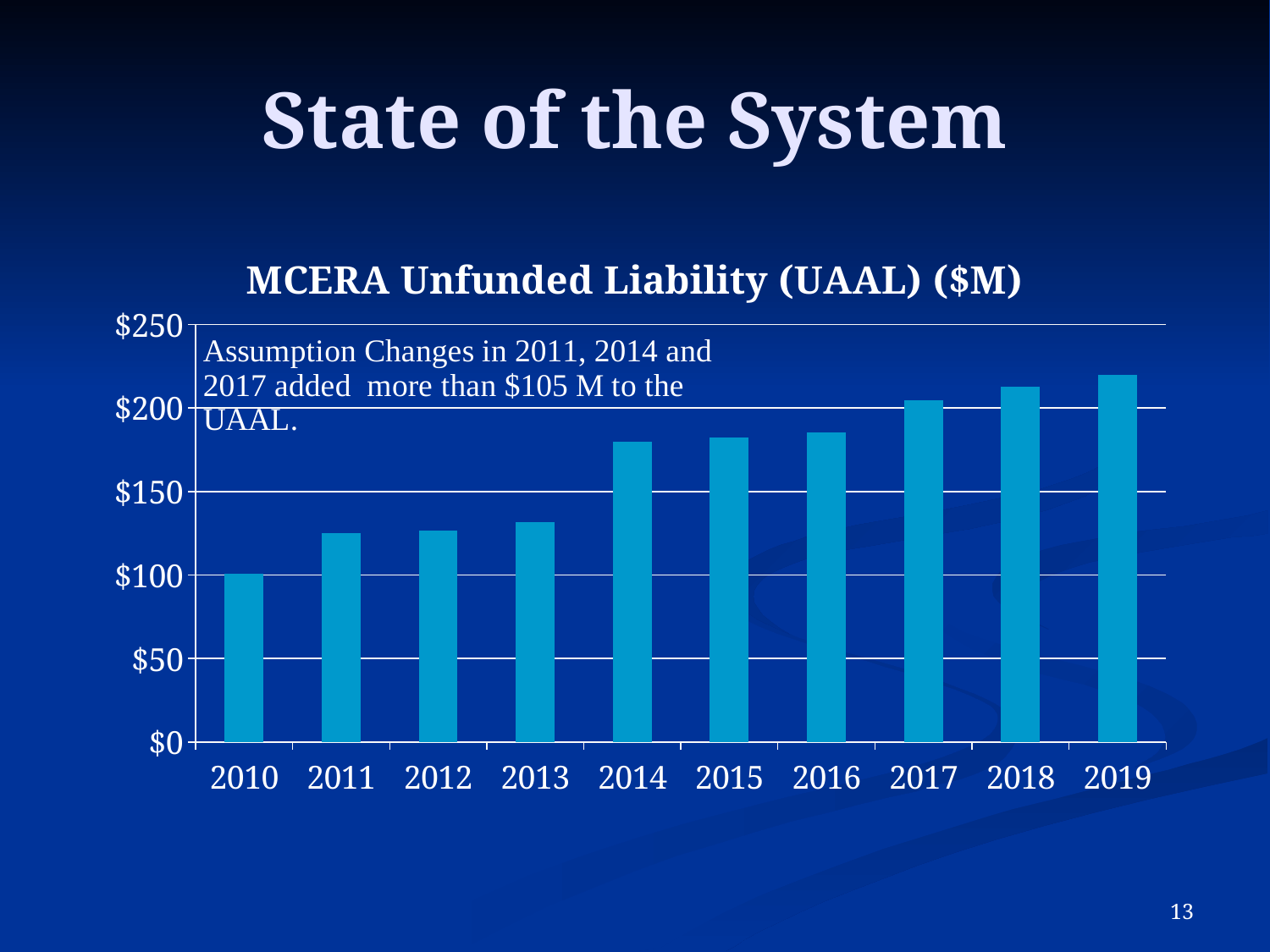
What is the title of the chart? MCERA Unfunded Liability (UAAL) ($M) Which year has the highest unfunded liability? 2019 How many years are shown on the x axis of the chart? 10 Which year has the lowest unfunded liability? 2010 Do the values generally rise or fall from 2010 to 2019? rise Is the value for 2013 greater or less than $150? less Which is larger, the value for 2014 or the value for 2013? 2014 Is the value for 2016 greater or less than $200? less Is the value for 2019 greater or less than $200? greater According to the text box on the chart, how much did assumption changes in 2011, 2014 and 2017 add to the UAAL? more than $105 M What kind of chart is shown on the slide? bar chart